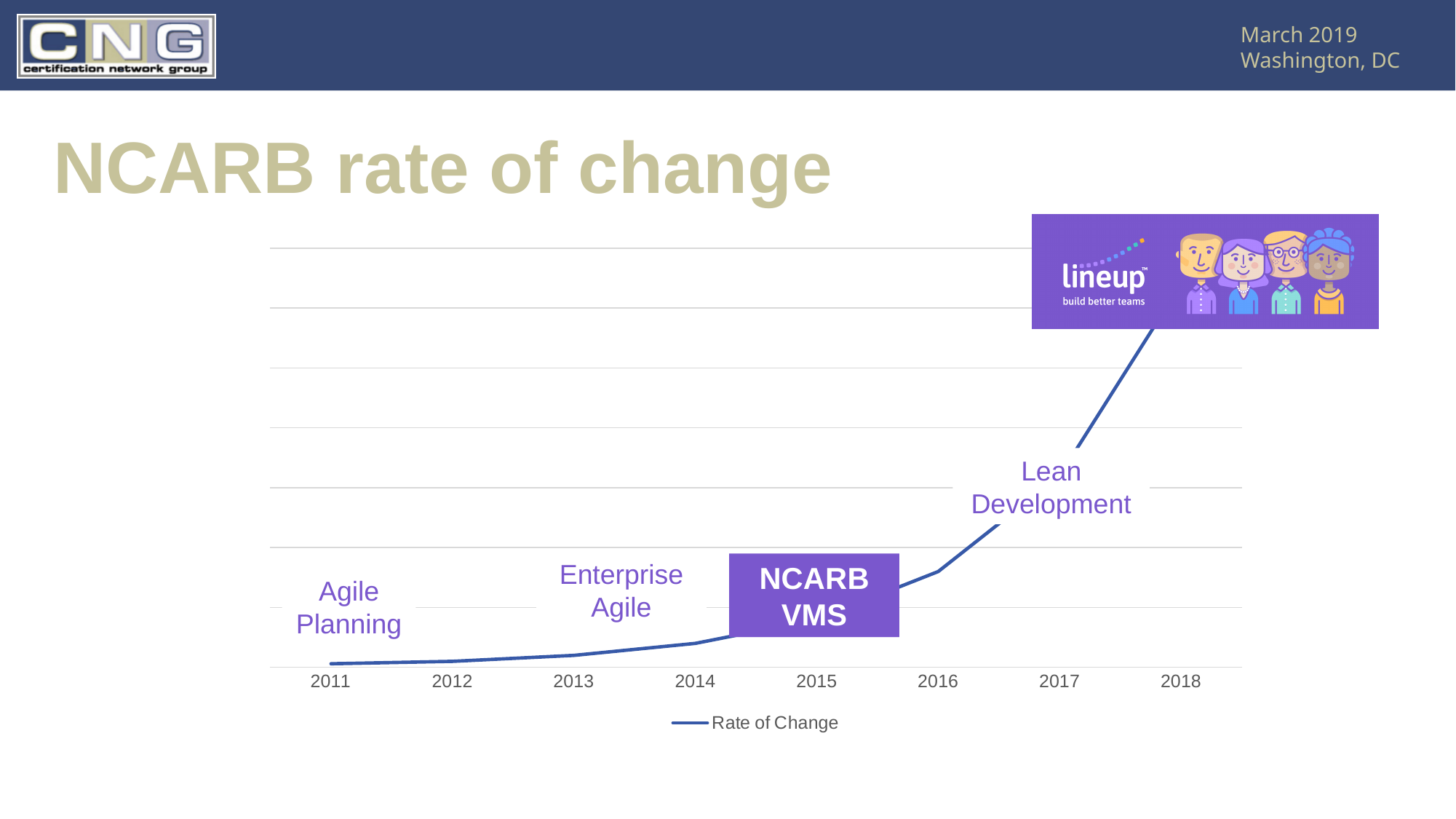
What kind of chart is shown on the slide? line chart Does the Rate of Change line rise or fall from 2011 to 2018? rise How many years are shown on the x axis of the chart? 8 Which year has the larger Rate of Change value, 2018 or 2015? 2018 How many series does the chart legend list? 1 Which year has the larger Rate of Change value, 2013 or 2017? 2017 Which year has the highest Rate of Change value? 2018 What is the first year shown on the x axis of the chart? 2011 Which year has the larger Rate of Change value, 2016 or 2012? 2016 Which year has the lowest Rate of Change value? 2011 What is the name of the series shown in the chart legend? Rate of Change